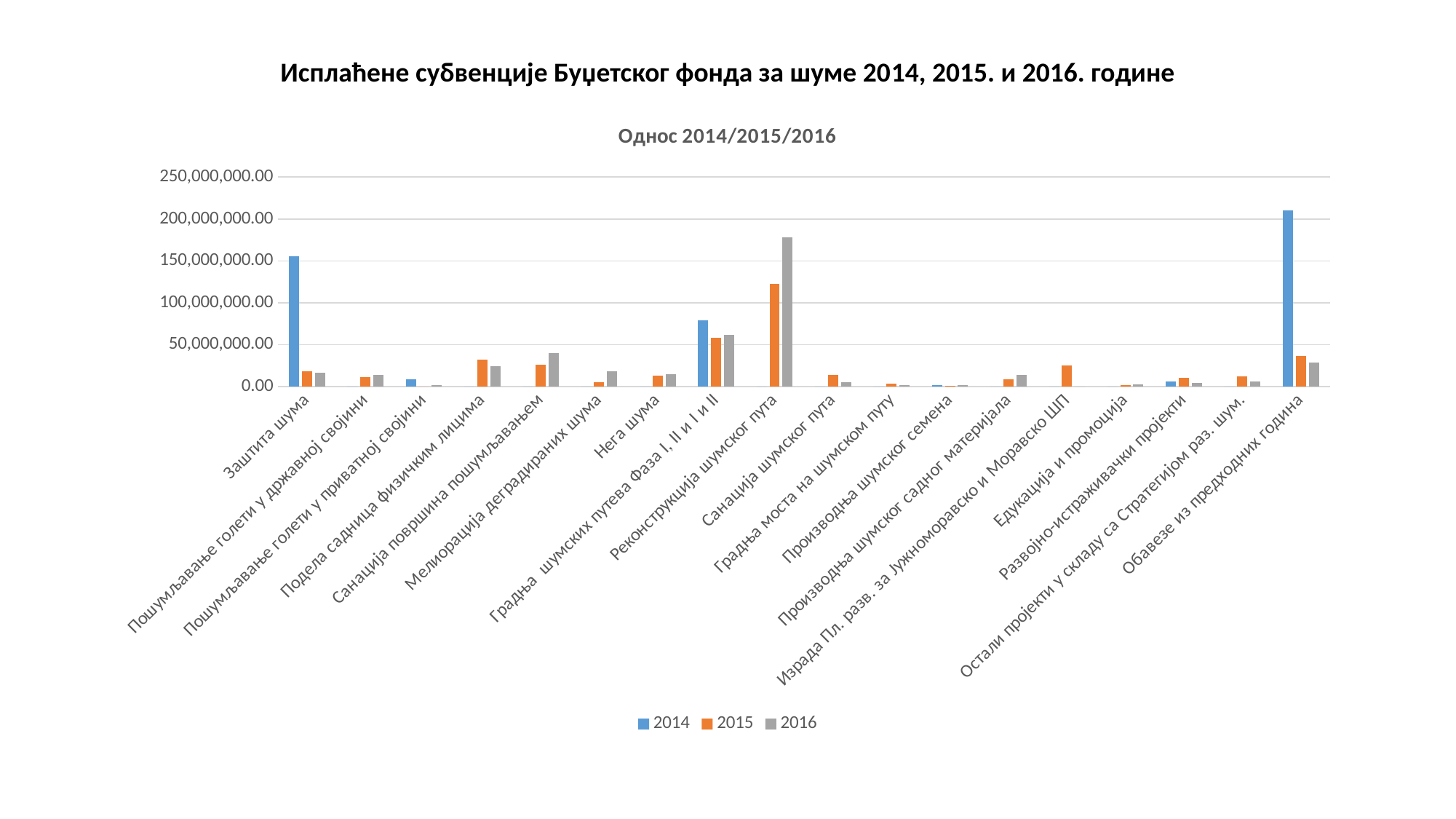
For the 2014 series, which is larger: Заштита шума or Обавезе из предходних година? Обавезе из предходних година Is the 2016 value for Реконструкција шумског пута greater or less than 150,000,000.00? greater Is the 2014 value for Обавезе из предходних година greater or less than 200,000,000.00? greater For Реконструкција шумског пута, which is larger: the 2015 value or the 2016 value? 2016 Which years are listed in the legend? 2014, 2015, 2016 How many series does the legend list? 3 Is the 2014 value for Градња шумских путева Фаза I, II и I и II greater or less than 100,000,000.00? less Which category has the highest value for the 2015 series? Реконструкција шумског пута How many categories are shown on the x axis? 18 Which category has the highest value for the 2016 series? Реконструкција шумског пута Which category has the highest value for the 2014 series? Обавезе из предходних година What kind of chart is shown on the slide? bar chart